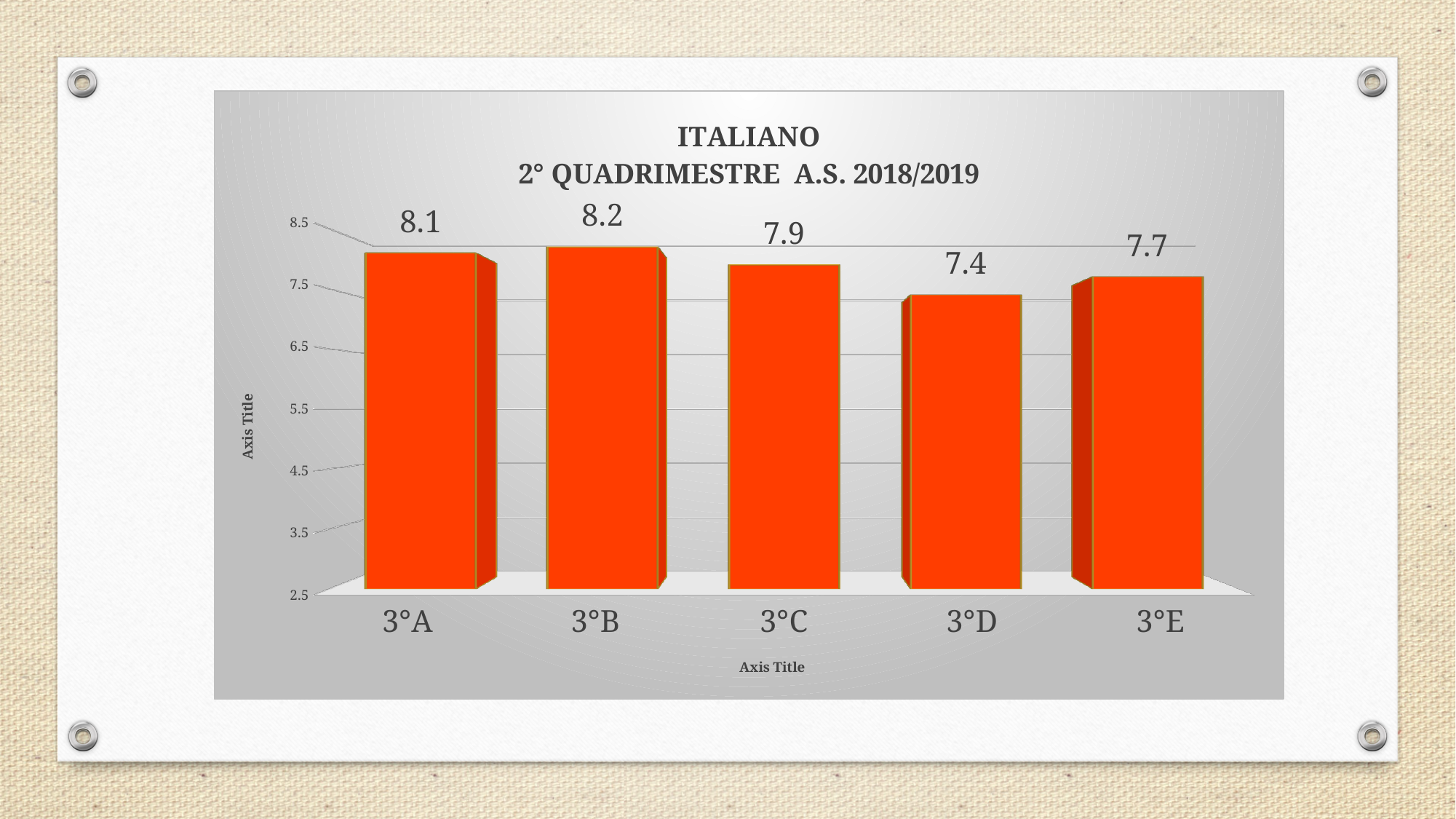
Is the value for 3°D greater or less than 7.5? less What is the value for 3°A? 8.1 Which class has the lowest value? 3°D Which is larger, the value for 3°A or the value for 3°E? 3°A Which class has the highest value? 3°B What is the difference between the values for 3°B and 3°D? 0.8 What is the value for 3°E? 7.7 What kind of chart is shown on the slide? bar chart How many classes are shown on the x axis? 5 What is the difference between the values for 3°C and 3°E? 0.2 What is the value for 3°D? 7.4 What is the title of the chart? ITALIANO 2° QUADRIMESTRE A.S. 2018/2019